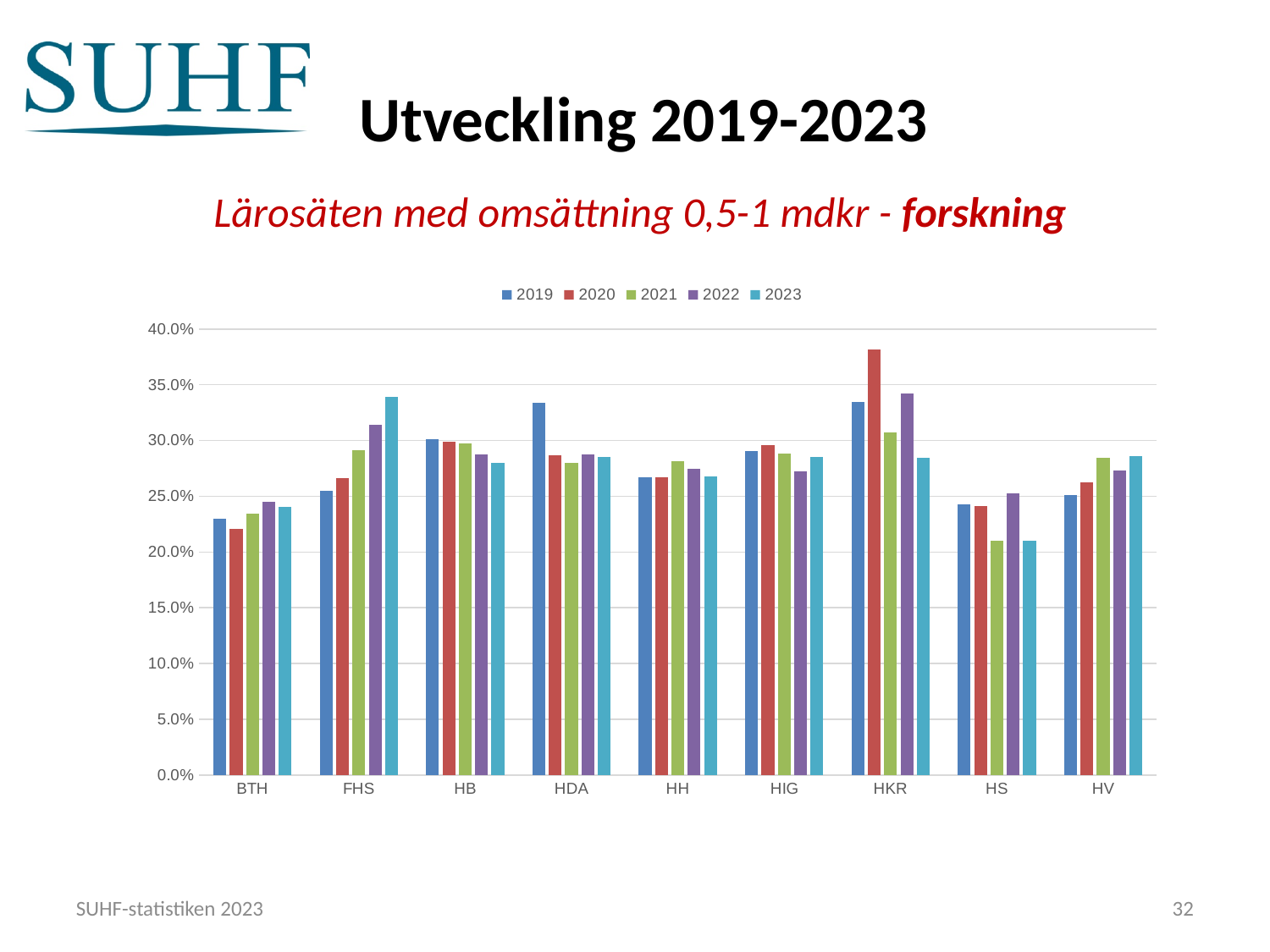
Which institution has the lowest value for 2021? HS What kind of chart is shown on the slide? bar chart Is the 2023 value for FHS greater or less than 30.0%? greater Do the values for FHS rise or fall from 2019 to 2023? rise For HDA, which year has the larger value, 2019 or 2020? 2019 What is the first entry in the chart legend? 2019 How many series does the legend list? 5 Which institution has the highest value for 2020? HKR Is the 2020 value for HKR greater or less than 35.0%? greater Which has the larger 2020 value, BTH or HKR? HKR Is the 2021 value for HS greater or less than 25.0%? less How many institutions (categories) are shown on the x axis? 9